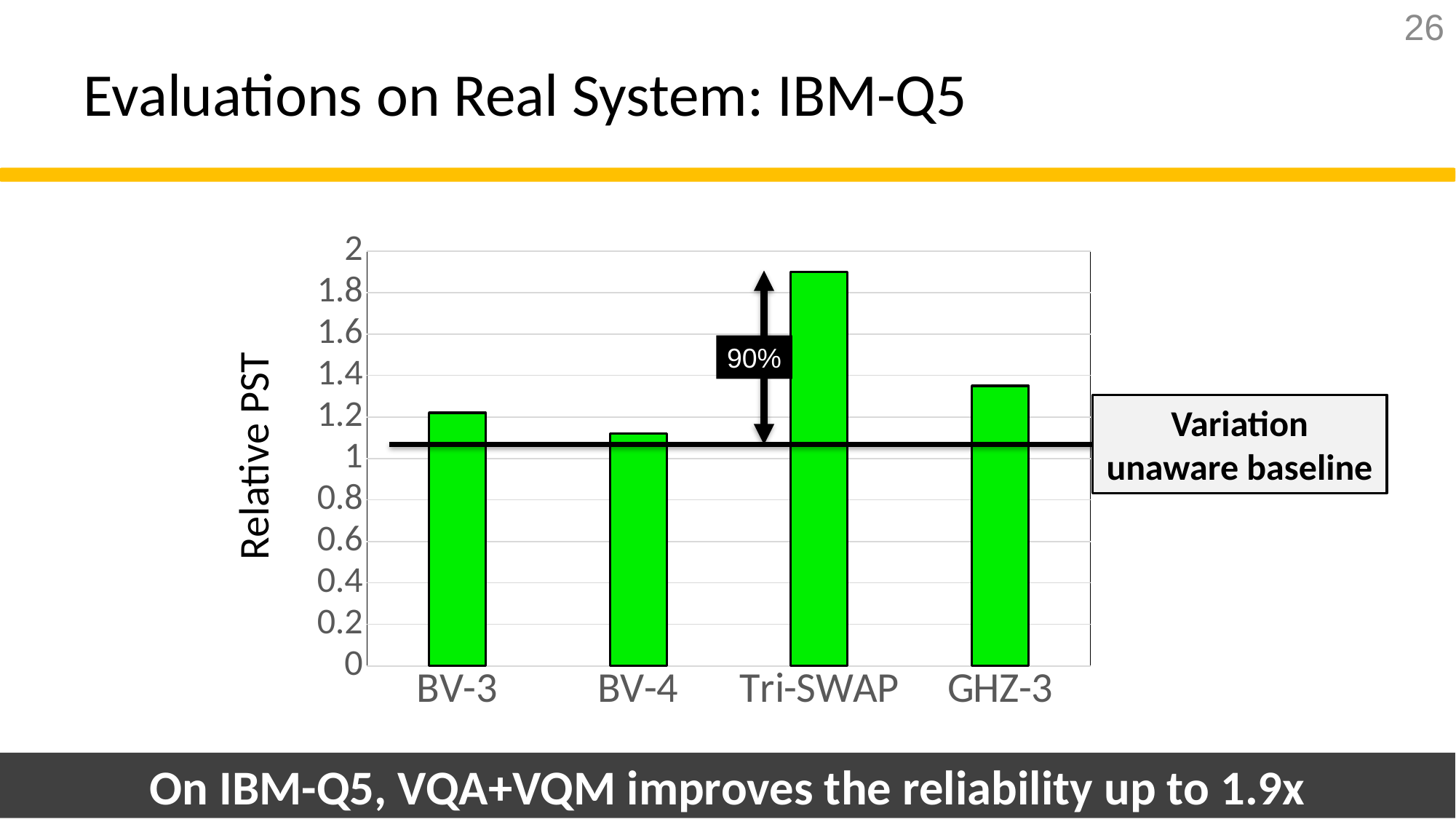
Which category has the highest Relative PST? Tri-SWAP Which has a higher Relative PST, GHZ-3 or BV-3? GHZ-3 Which has a higher Relative PST, Tri-SWAP or GHZ-3? Tri-SWAP Is the Relative PST for Tri-SWAP greater or less than 1.8? greater Is the Relative PST for BV-3 greater or less than 1.4? less Which category has the lowest Relative PST? BV-4 What percentage is shown in the annotation next to the Tri-SWAP bar? 90% Is the Relative PST for BV-4 greater or less than 1.2? less What is the label on the y axis of the chart? Relative PST What kind of chart is shown on the slide? bar chart How many categories are plotted on the x axis of the chart? 4